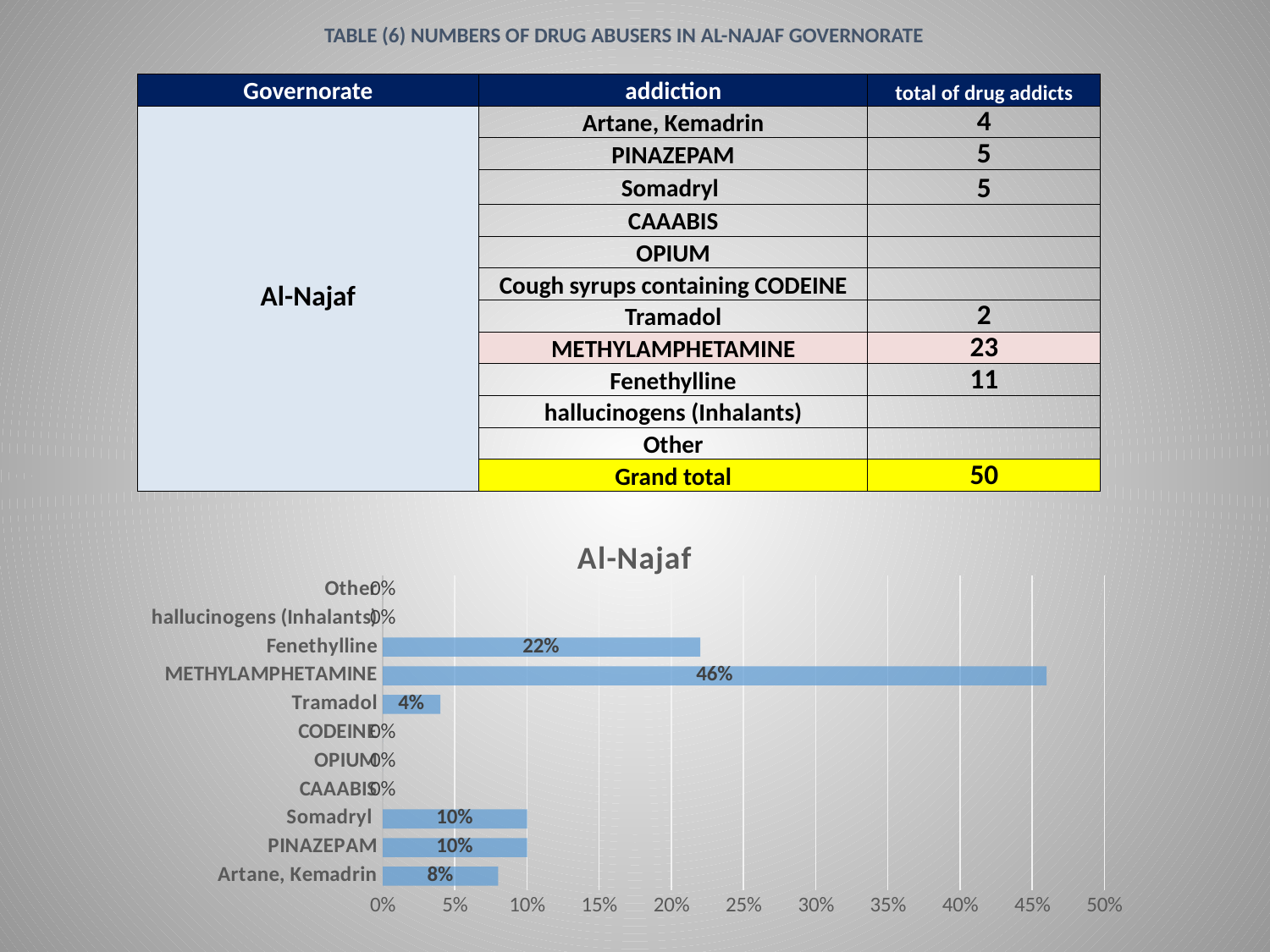
What is the difference between the values for METHYLAMPHETAMINE and Fenethylline? 24% Which category has the highest value in the chart? METHYLAMPHETAMINE What is the title of the chart? Al-Najaf What is the value for Fenethylline in the chart? 22% Is the value for METHYLAMPHETAMINE greater or less than 40%? greater How many categories are shown on the chart's y axis? 11 What is the value for METHYLAMPHETAMINE in the chart? 46% What type of chart is shown on the slide? bar chart How many categories in the chart have a value of 0%? 5 What is the value for Tramadol in the chart? 4% What is the value for Artane, Kemadrin in the chart? 8% Which is larger, the value for Somadryl or the value for Artane, Kemadrin? Somadryl